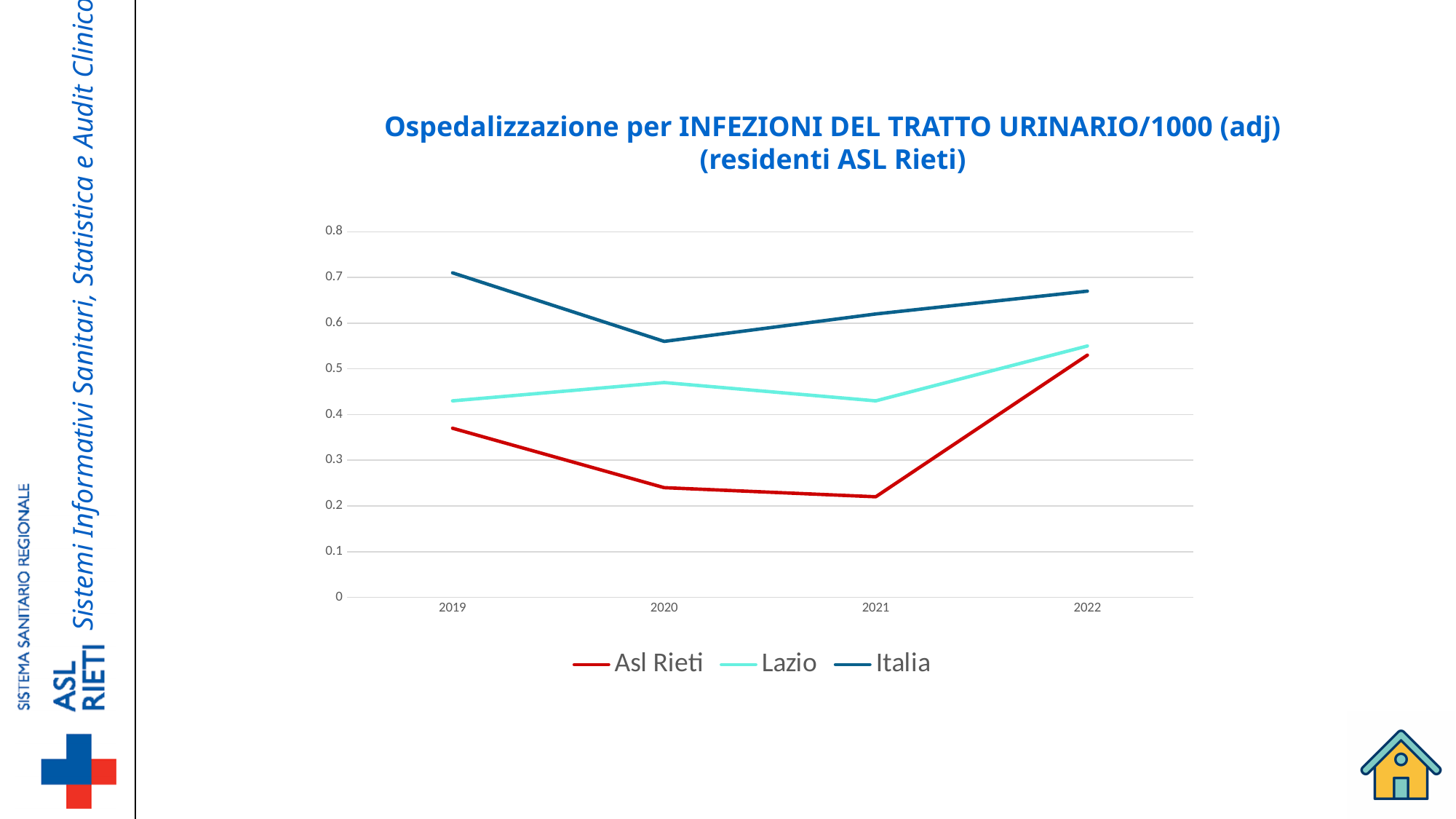
What kind of chart is shown on the slide? line chart Is the value for Lazio in 2020 greater or less than 0.4? greater In which year is the Italia series at its highest? 2019 Which series is drawn in red? Asl Rieti How many series does the legend list? 3 In which year is the Italia series at its lowest? 2020 Is the value for Italia in 2019 greater or less than 0.6? greater Is the value for Asl Rieti in 2019 greater or less than 0.4? less How many years are shown on the x axis? 4 In 2020, which is larger: the value for Lazio or the value for Asl Rieti? Lazio Does the Asl Rieti series rise or fall from 2019 to 2020? fall